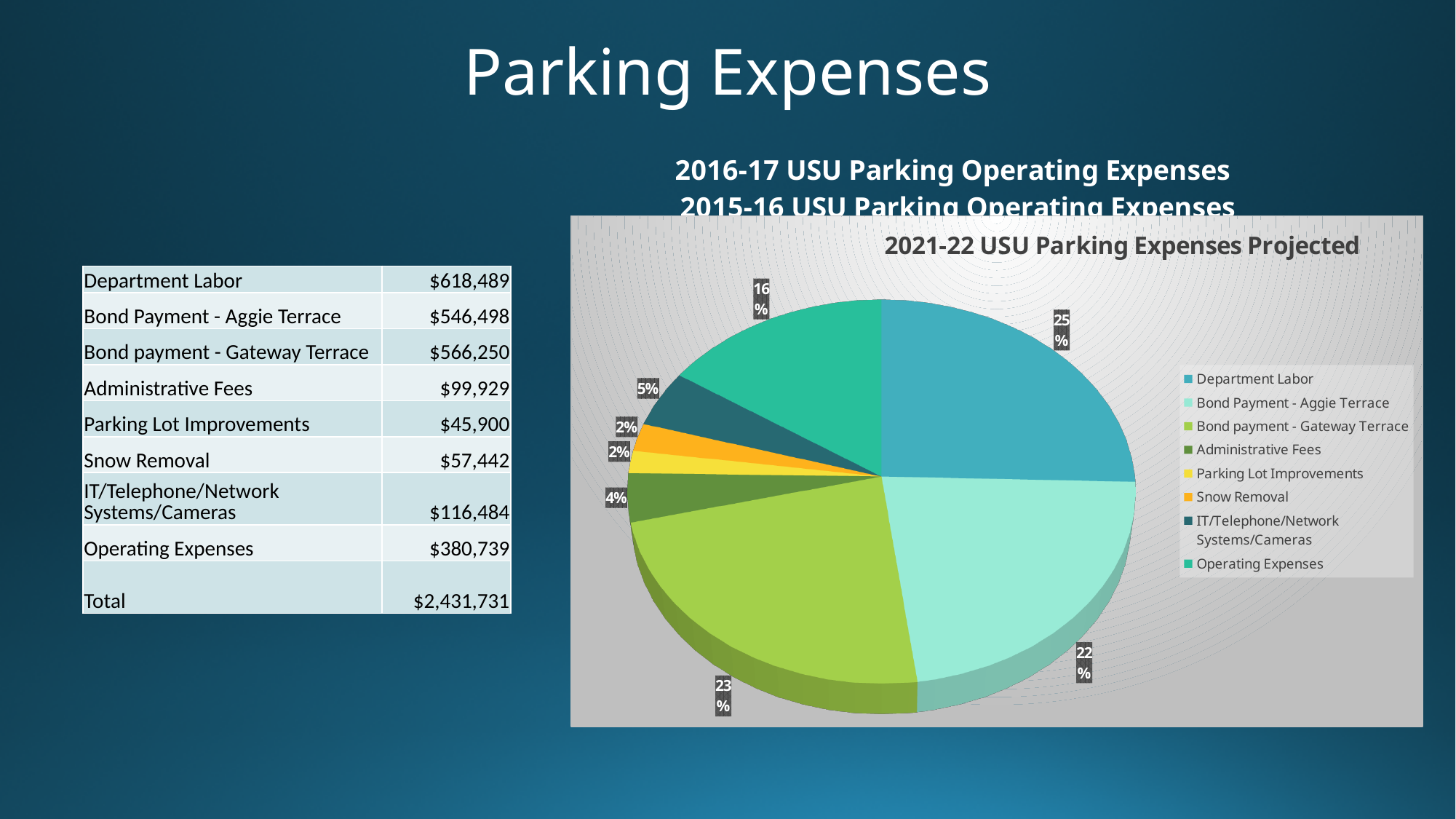
What kind of chart is shown on the slide? pie chart What is the title of the pie chart? 2021-22 USU Parking Expenses Projected What percentage of the pie chart is Bond payment - Gateway Terrace? 23% How many entries does the pie chart's legend list? 8 Which category has the largest slice of the pie chart? Department Labor What percentage of the pie chart is Administrative Fees? 4% How many slices does the pie chart have? 8 What percentage of the pie chart is IT/Telephone/Network Systems/Cameras? 5% By how many percentage points does the Department Labor slice exceed the Operating Expenses slice? 9 What percentage of the pie chart is Department Labor? 25% Which slice is larger in the pie chart: Bond Payment - Aggie Terrace or Bond payment - Gateway Terrace? Bond payment - Gateway Terrace What percentage of the pie chart is Operating Expenses? 16%